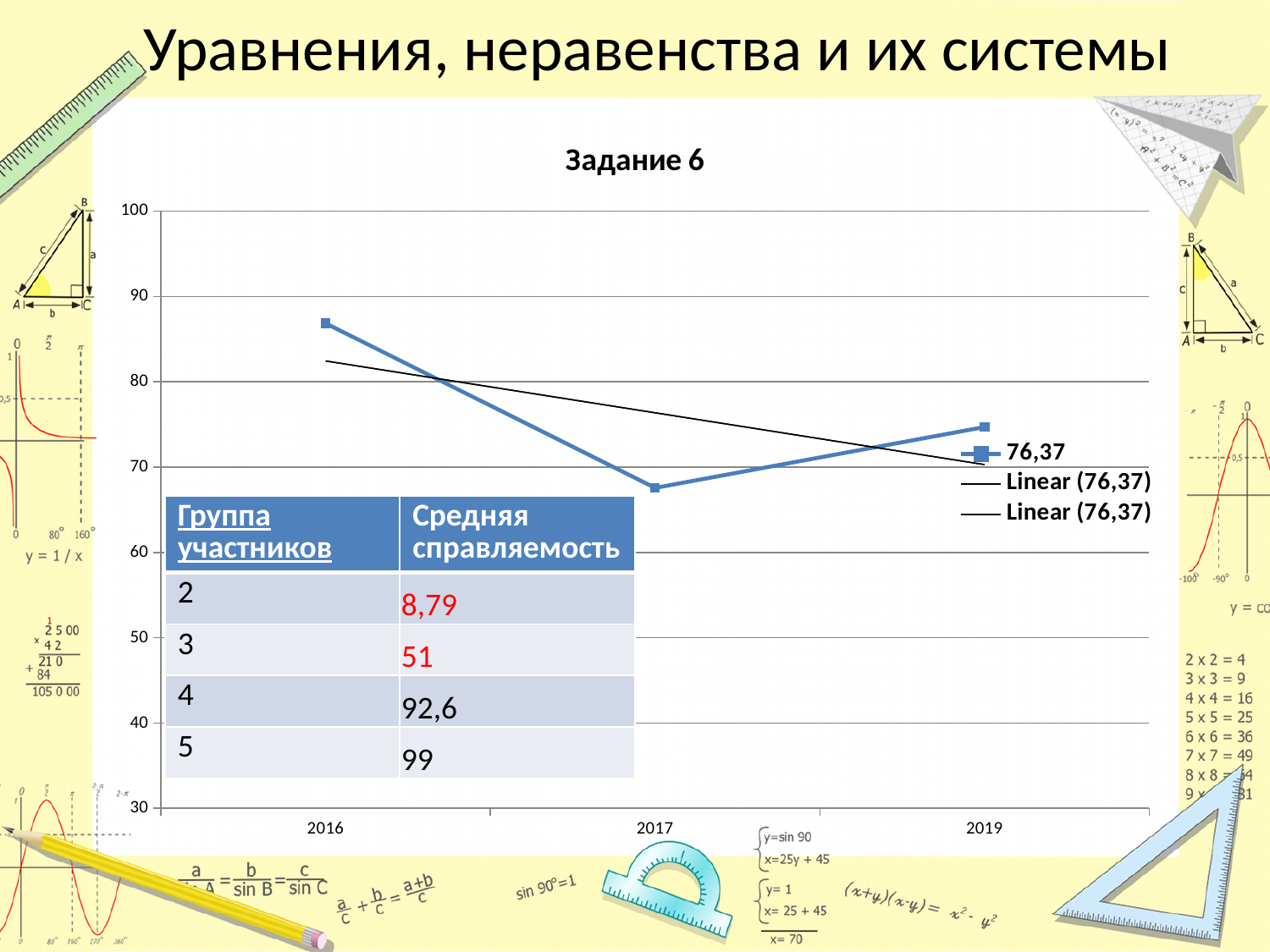
Is the value for 2019 greater or less than 70? greater Is the value for 2016 greater or less than 80? greater What kind of chart is shown on the slide? line chart What is the title of the chart? Задание 6 Which year has the lowest value on the plotted line? 2017 Which year has the larger value, 2016 or 2019? 2016 How many entries does the chart's legend list? 3 How many years are plotted on the x axis of the chart? 3 Which year has the highest value on the plotted line? 2016 Is the value for 2017 greater or less than 70? less Does the straight trendline (Linear) rise or fall from left to right? fall Does the plotted line rise or fall from 2016 to 2017? fall